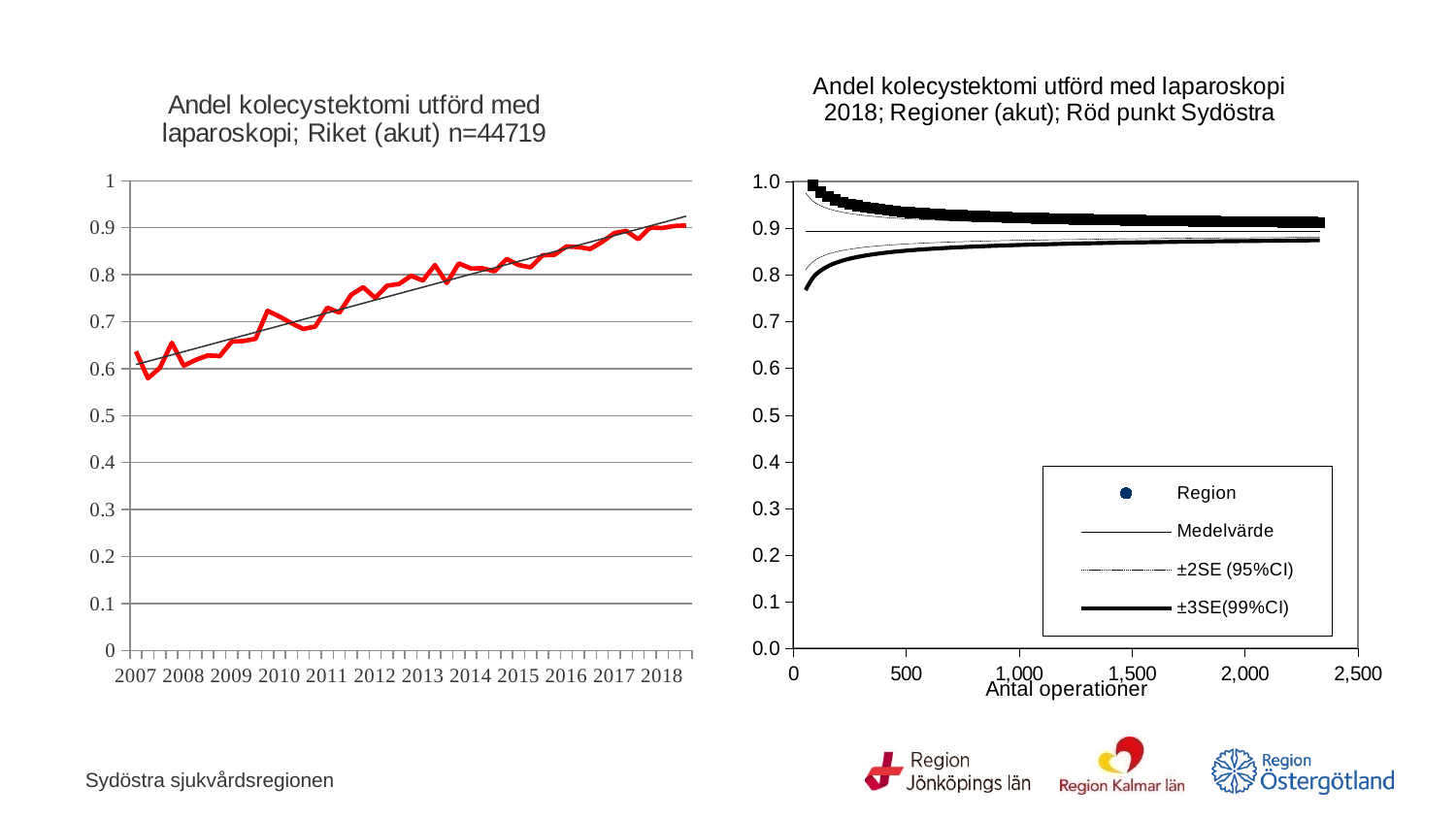
In the left chart (Riket (akut)), is the value at the start of 2007 greater or less than 0.7? less How many entries does the legend of the right chart (2018; Regioner (akut)) list? 4 In the right chart (2018; Regioner (akut)), is the lower ±3SE(99%CI) line at its leftmost point greater or less than 0.7? greater In the left chart (Riket (akut)), which is larger, the value at the end of 2018 or the value at the start of 2007? 2018 What kind of chart is the left chart titled 'Andel kolecystektomi utförd med laparoskopi; Riket (akut) n=44719'? line chart In the left chart (Riket (akut)), is the value at the end of 2018 greater or less than 0.8? greater How many years are labelled on the x axis of the left chart (Riket (akut))? 12 In the left chart (Riket (akut)), do the values generally rise or fall from 2007 to 2018? rise What is the sample size n stated in the title of the left chart? 44719 What is the x-axis label of the right chart (2018; Regioner (akut))? Antal operationer